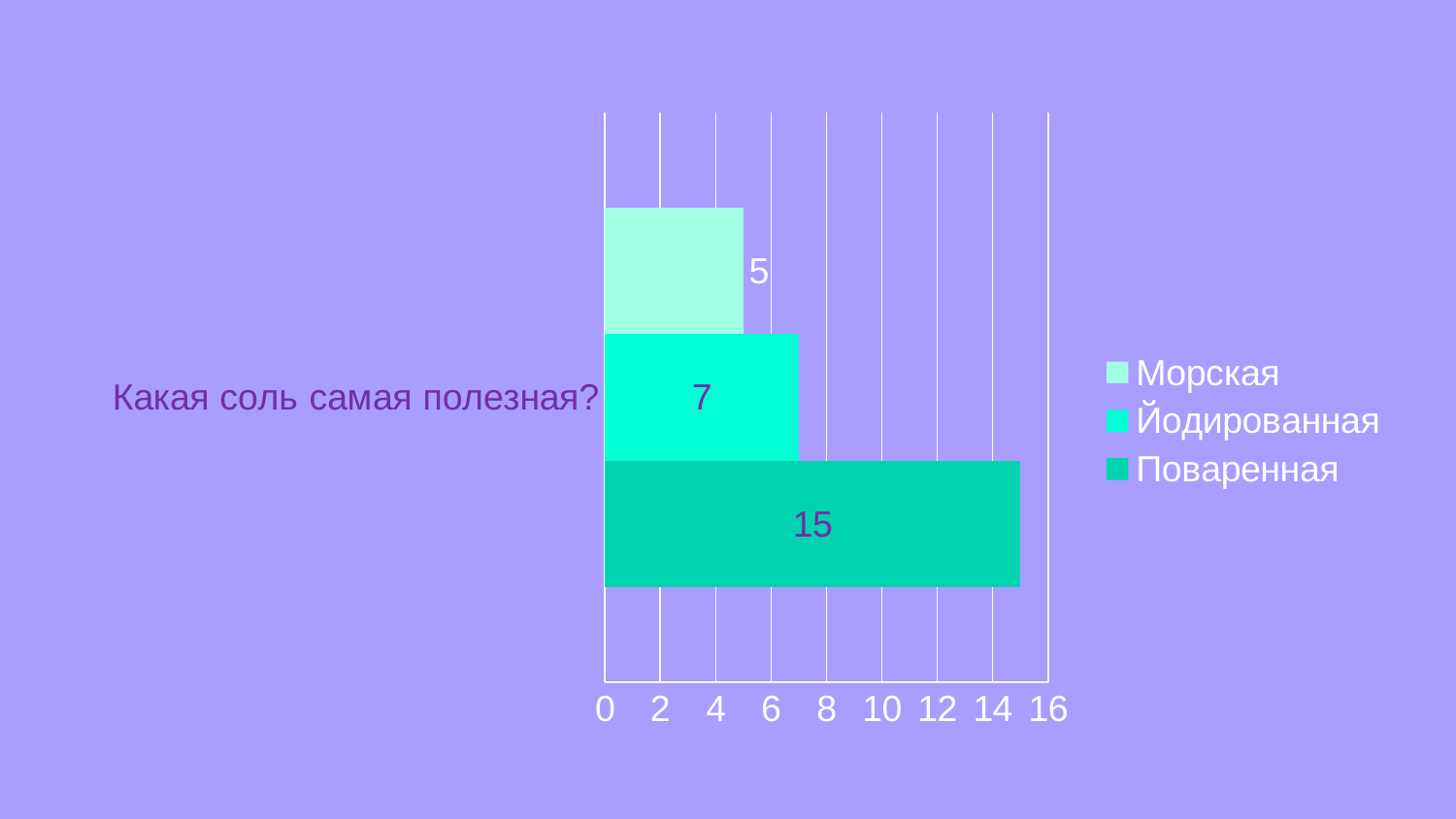
What is the difference between the values for Йодированная and Морская? 2 What kind of chart is shown on the slide? bar chart Which salt type has the highest value? Поваренная What is the difference between the values for Поваренная and Йодированная? 8 What value is shown for Йодированная? 7 What value is shown for Поваренная? 15 How many series does the legend list? 3 Which is larger, the value for Морская or the value for Йодированная? Йодированная What value is shown for Морская? 5 Which salt type has the lowest value? Морская What question is written next to the chart? Какая соль самая полезная? Is the value for Поваренная greater or less than 10? greater